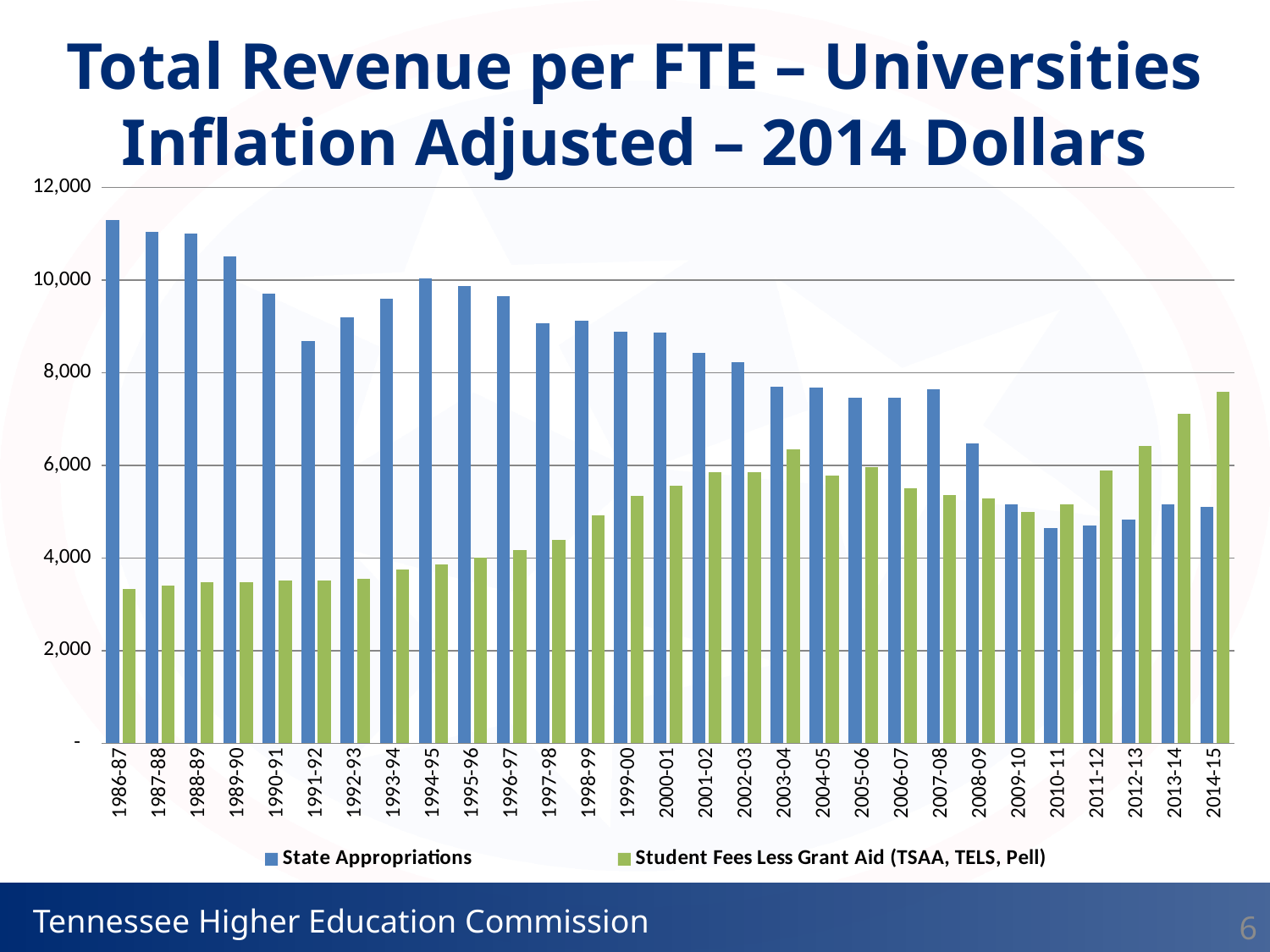
How many fiscal years are shown along the x axis? 29 In which year is Student Fees Less Grant Aid (TSAA, TELS, Pell) highest? 2014-15 Is the value for Student Fees Less Grant Aid in 2014-15 greater or less than 6,000? greater Is the value for Student Fees Less Grant Aid in 1986-87 greater or less than 4,000? less Overall, do State Appropriations rise or fall from 1986-87 to 2014-15? Fall How many series does the legend list? 2 In 1986-87, which is larger: State Appropriations or Student Fees Less Grant Aid? State Appropriations In which year is State Appropriations highest? 1986-87 Is the value for State Appropriations in 1986-87 greater or less than 10,000? greater In 2014-15, which is larger: State Appropriations or Student Fees Less Grant Aid? Student Fees Less Grant Aid What kind of chart is shown on the slide? Bar chart